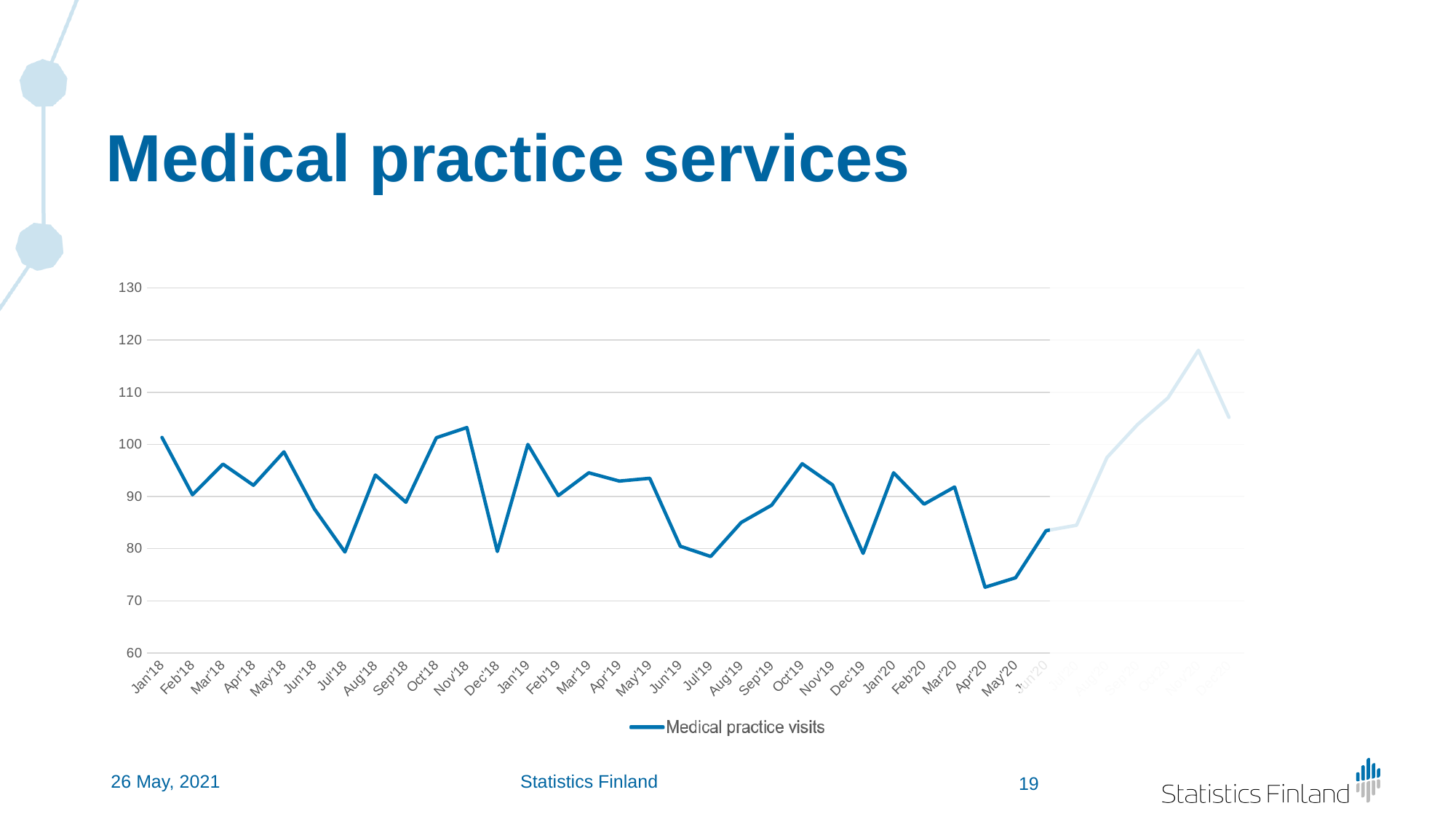
Which month has the lowest value for Medical practice visits? Apr'20 Is the value for Nov'18 greater or less than 100? greater Which is larger, the value for Jan'18 or the value for Apr'20? Jan'18 What kind of chart is shown on the slide? line chart How many series does the legend list? 1 Is the value for Jun'19 greater or less than 90? less Is the value for Apr'20 greater or less than 80? less What is the name of the series shown in the legend? Medical practice visits Which is larger, the value for Nov'18 or the value for Dec'18? Nov'18 Do the values rise or fall from Jan'20 to Apr'20? fall